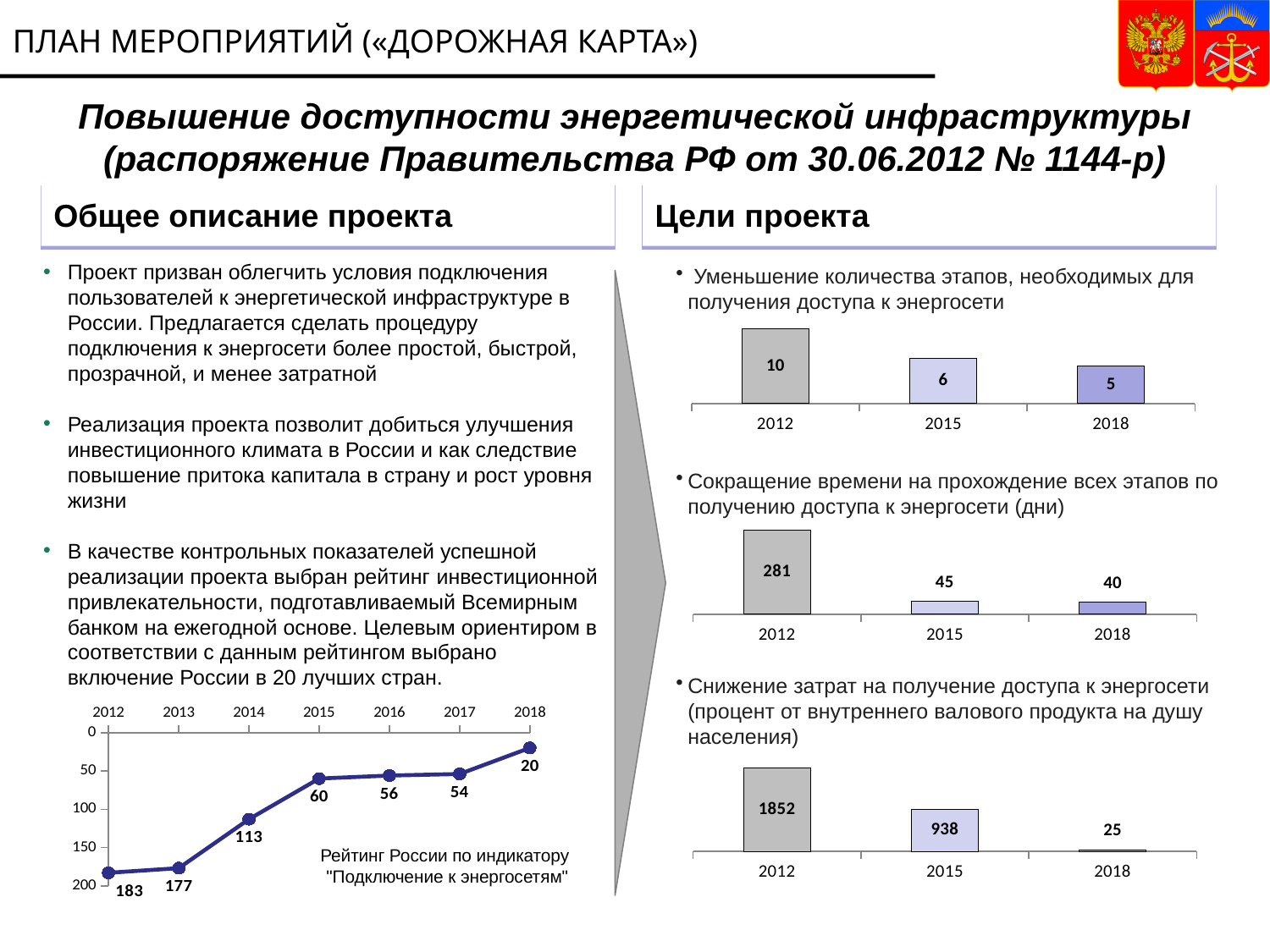
In the bottom right bar chart (Снижение затрат на получение доступа к энергосети), which year has the lowest value? 2018 In the middle right bar chart (Сокращение времени на прохождение всех этапов по получению доступа к энергосети), what is the difference between the values for 2015 and 2018? 5 In the line chart at the bottom left (Рейтинг России по индикатору «Подключение к энергосетям»), how many data points are plotted? 7 In the middle right bar chart (Сокращение времени на прохождение всех этапов по получению доступа к энергосети), what is the value for 2012? 281 In the bottom right bar chart (Снижение затрат на получение доступа к энергосети), what is the value for 2015? 938 In the line chart at the bottom left (Рейтинг России по индикатору «Подключение к энергосетям»), what is the value for 2014? 113 In the bottom right bar chart (Снижение затрат на получение доступа к энергосети), do the values rise or fall from 2012 to 2018? fall In the top right bar chart (Уменьшение количества этапов, необходимых для получения доступа к энергосети), what is the value for 2015? 6 In the line chart at the bottom left (Рейтинг России по индикатору «Подключение к энергосетям»), what is the difference between the values for 2012 and 2013? 6 What type of chart is used for the three charts on the right side of the slide? bar chart In the line chart at the bottom left (Рейтинг России по индикатору «Подключение к энергосетям»), what is the value for 2018? 20 In the top right bar chart (Уменьшение количества этапов, необходимых для получения доступа к энергосети), which year has the highest value? 2012